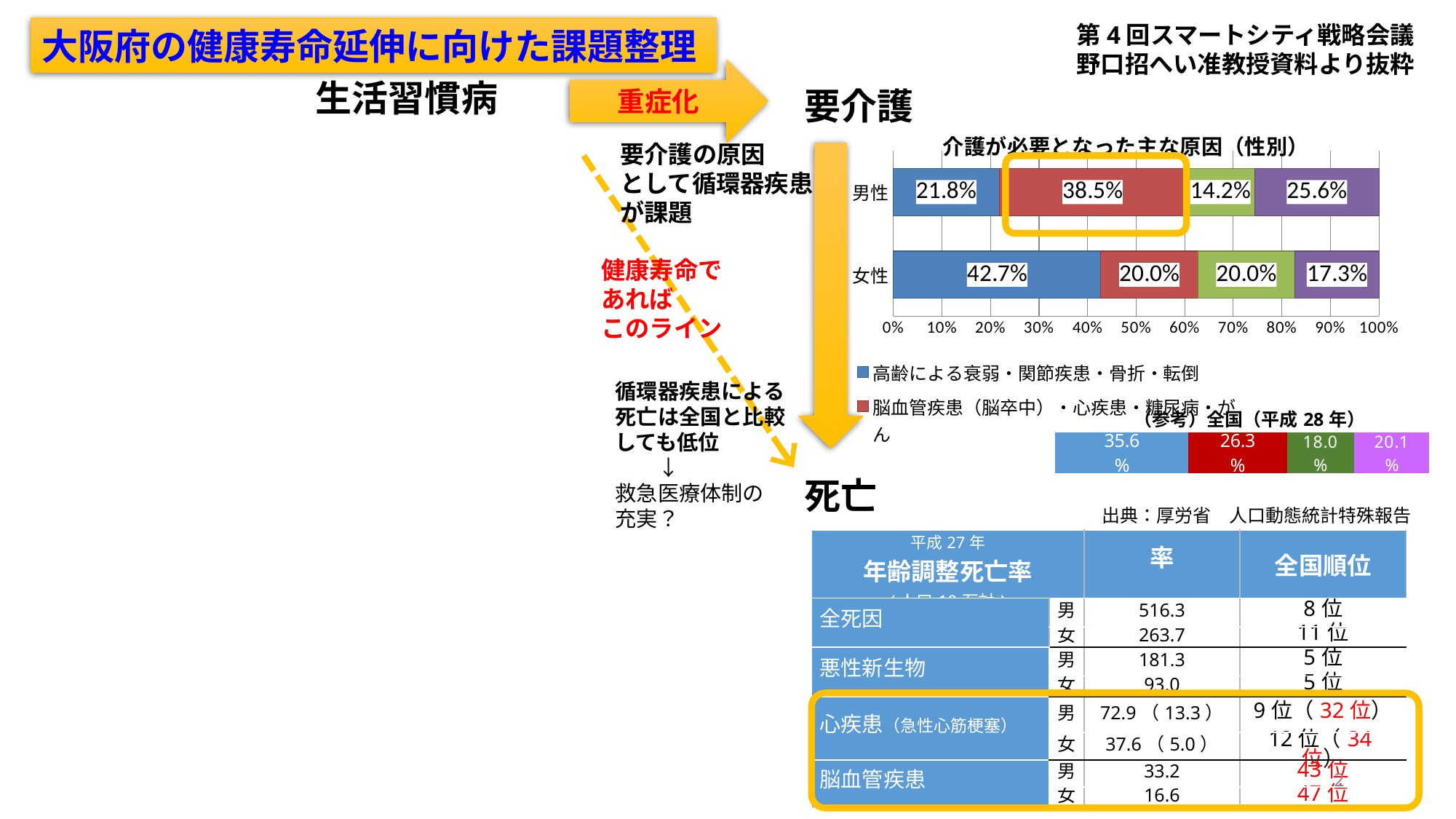
In the chart 「介護が必要となった主な原因（性別）」, what is the value of the red segment (脳血管疾患（脳卒中）・心疾患・糖尿病・がん) for 男性? 38.5% In the chart 「介護が必要となった主な原因（性別）」, what is the value of the green segment for 女性? 20.0% How many categories (bars) does the chart 「介護が必要となった主な原因（性別）」 show? 2 In the chart 「介護が必要となった主な原因（性別）」, what is the value of the purple segment for 男性? 25.6% In the chart 「介護が必要となった主な原因（性別）」, what is the maximum value shown on the x axis? 100% In the chart 「介護が必要となった主な原因（性別）」, which is larger: the blue segment for 男性 or the blue segment for 女性? 女性 In the chart 「介護が必要となった主な原因（性別）」, which segment is the largest for 男性? 脳血管疾患（脳卒中）・心疾患・糖尿病・がん (38.5%) In the reference bar 「（参考）全国（平成28年）」, what is the value of the first (blue) segment? 35.6% In the chart 「介護が必要となった主な原因（性別）」, which segment is the smallest for 女性? the purple segment (17.3%) In the chart 「介護が必要となった主な原因（性別）」, what is the value of the blue segment (高齢による衰弱・関節疾患・骨折・転倒) for 女性? 42.7% In the chart 「介護が必要となった主な原因（性別）」, what is the difference between the red segment values for 男性 and 女性? 18.5% What kind of chart is 「介護が必要となった主な原因（性別）」? stacked bar chart